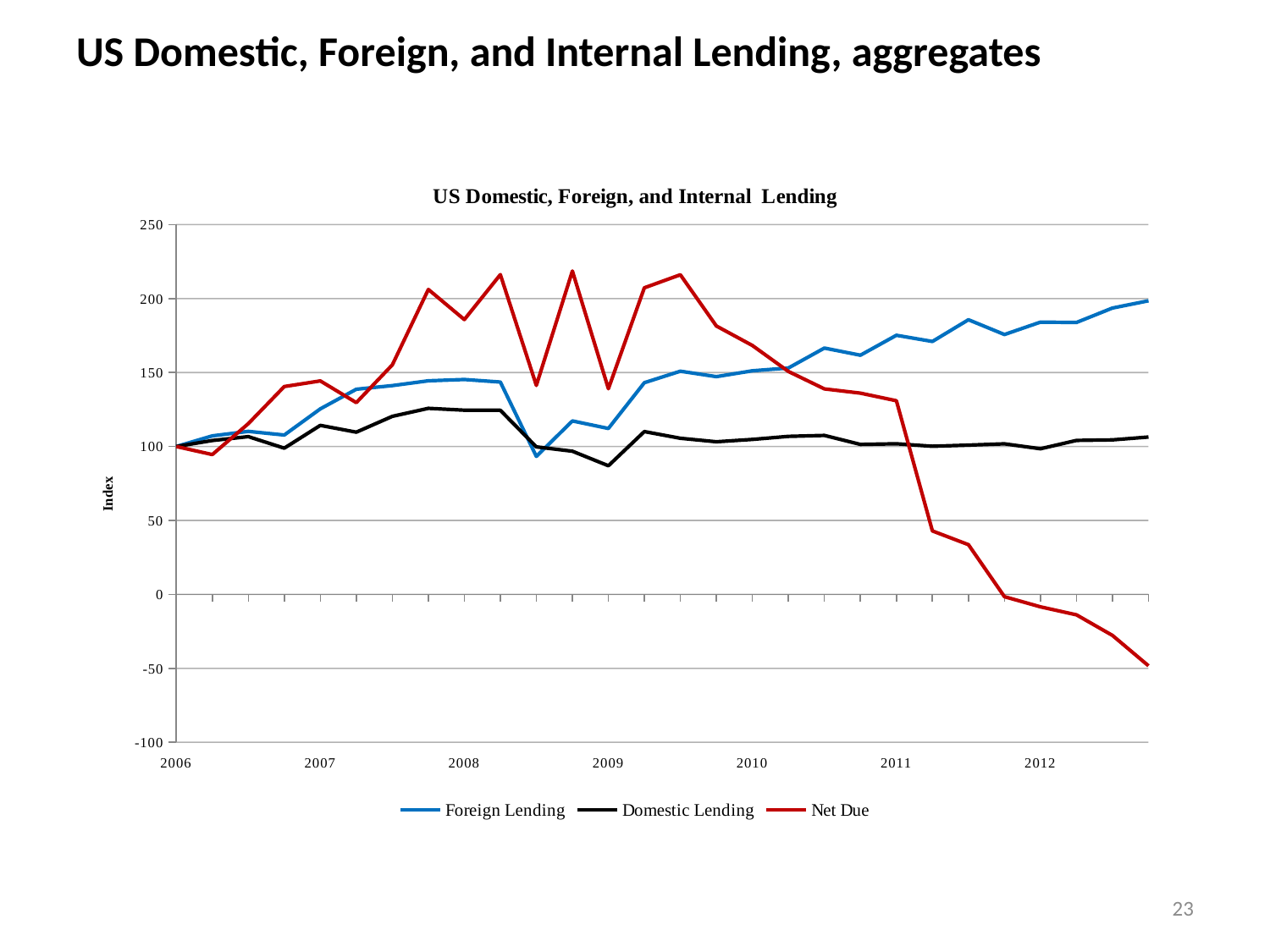
Is the value for Foreign Lending at the end of 2012 greater or less than 150? greater What kind of chart is shown on the slide? line chart At the end of 2012, which is larger: Foreign Lending or Domestic Lending? Foreign Lending Does Foreign Lending rise or fall between 2010 and the end of 2012? rise Is the value for Net Due at the end of 2012 greater or less than 0? less What is the title of the chart? US Domestic, Foreign, and Internal Lending Is the value for Net Due at the start of 2011 greater or less than 100? greater Does Net Due rise or fall between 2011 and the end of 2012? fall How many series does the legend list? 3 What is the label on the vertical axis? Index Which series is drawn in red? Net Due